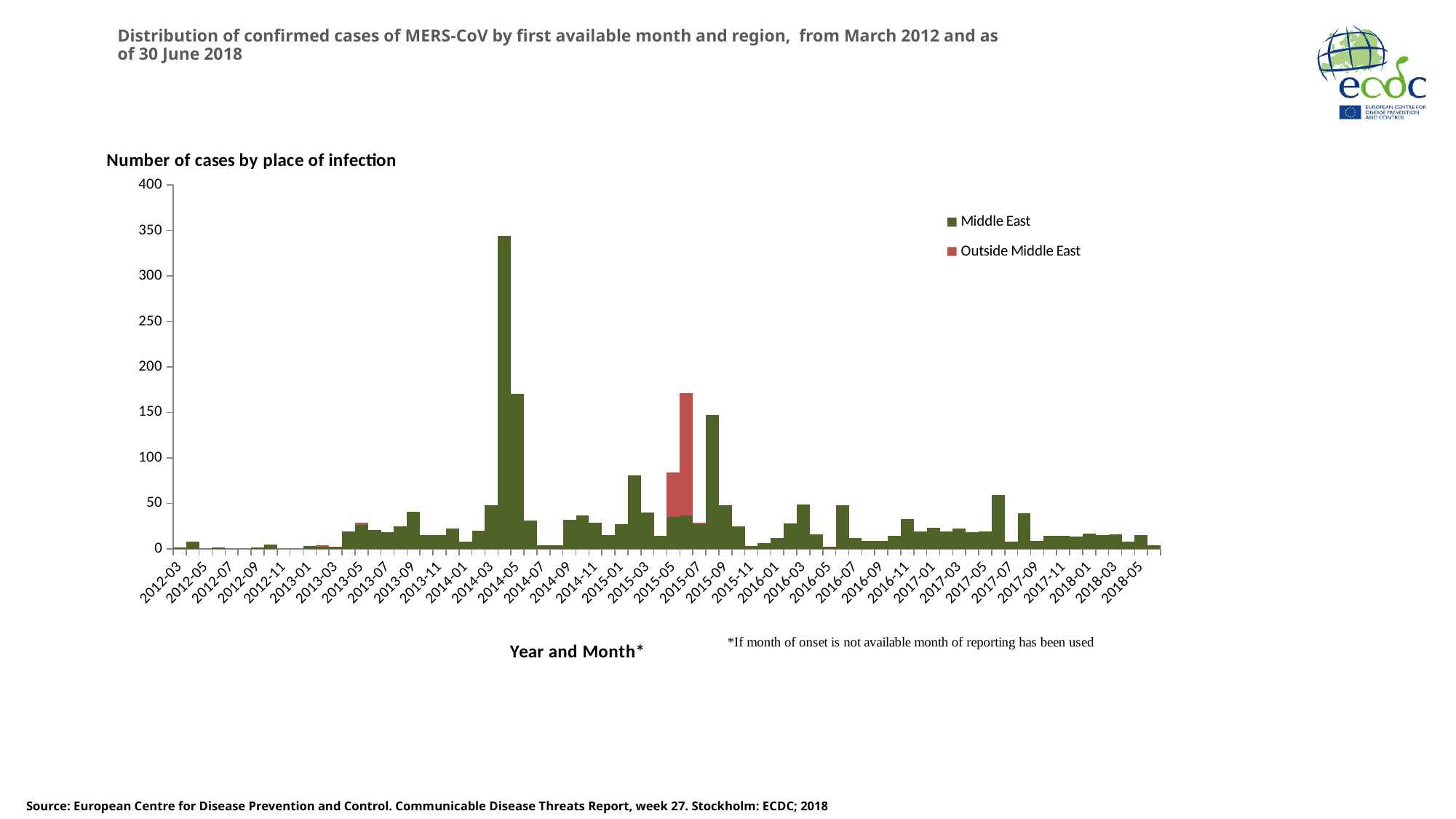
How many series does the legend list? 2 Which series does the tallest bar in the chart belong to? Middle East What are the two series named in the legend? Middle East and Outside Middle East Is the value for 2018-05 greater or less than 50? less Is the largest Outside Middle East segment greater or less than 100? greater Is the tallest bar in the chart greater or less than 300? greater What kind of chart is shown on the slide? Stacked bar chart What is the highest value shown on the y axis? 400 Which colour represents the Outside Middle East series? Red